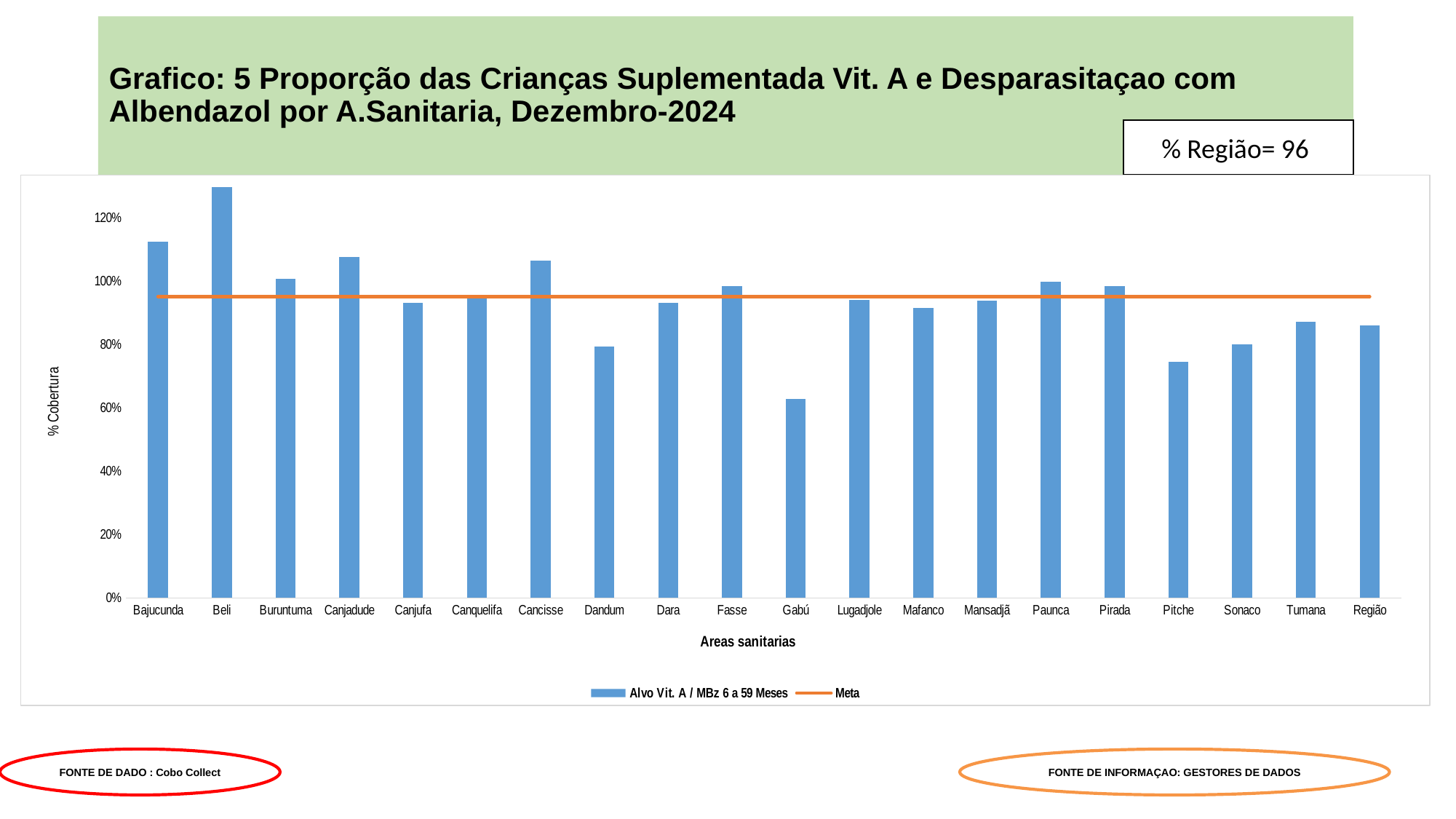
Is the value for Gabú greater or less than 80%? less What kind of chart is shown on the slide? combination bar and line chart Is the value for Bajucunda greater or less than 100%? greater How many series does the chart legend list? 2 Which health area has the highest coverage bar? Beli What value is given for % Região in the box at the top right of the slide? 96 Which health area has the lowest coverage bar? Gabú What is the title of the x axis of the chart? Areas sanitarias Is the value for Pitche greater or less than 80%? less How many health areas (categories) are shown on the x axis of the chart? 20 Which has the larger coverage value, Dandum or Gabú? Dandum